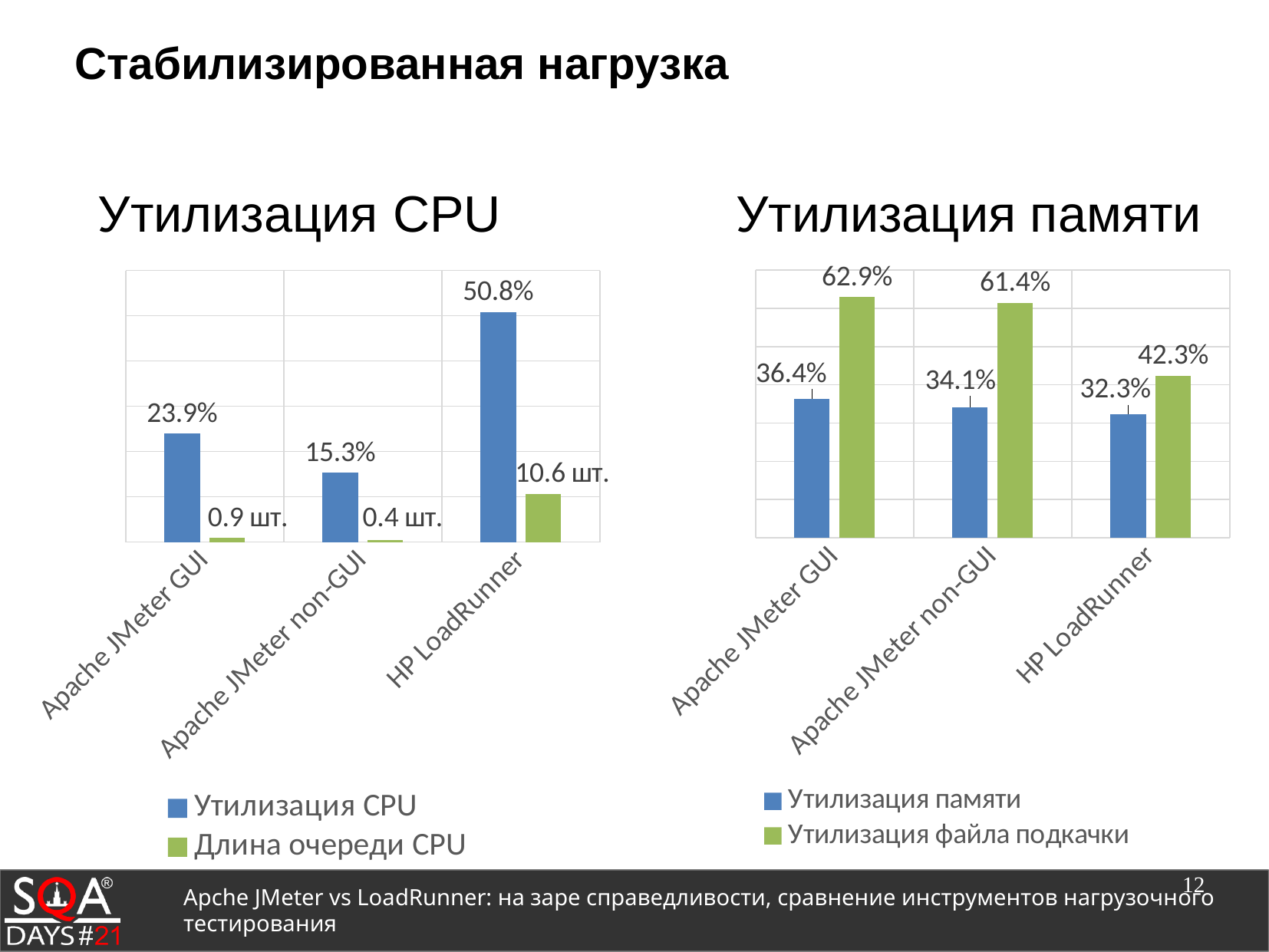
In the "Утилизация памяти" chart, what is the memory utilization for HP LoadRunner? 32.3% In the "Утилизация памяти" chart, which tool has the highest page file utilization? Apache JMeter GUI In the "Утилизация CPU" chart, what is the CPU utilization for HP LoadRunner? 50.8% What type of chart is the "Утилизация CPU" chart? Bar chart In the "Утилизация CPU" chart, what is the CPU queue length (Длина очереди CPU) for Apache JMeter non-GUI? 0.4 шт. In the "Утилизация CPU" chart, how many series does the legend list? 2 How many tools (categories) are compared in the "Утилизация памяти" chart? 3 In the "Утилизация CPU" chart, what is the difference in CPU utilization between HP LoadRunner and Apache JMeter GUI? 26.9% In the "Утилизация CPU" chart, which tool has the lowest CPU utilization? Apache JMeter non-GUI In the "Утилизация памяти" chart, what is the page file utilization (Утилизация файла подкачки) for Apache JMeter GUI? 62.9% In the "Утилизация памяти" chart, what is the difference between page file utilization and memory utilization for HP LoadRunner? 10.0% In the "Утилизация памяти" chart, which is larger: the memory utilization of Apache JMeter GUI or of HP LoadRunner? Apache JMeter GUI